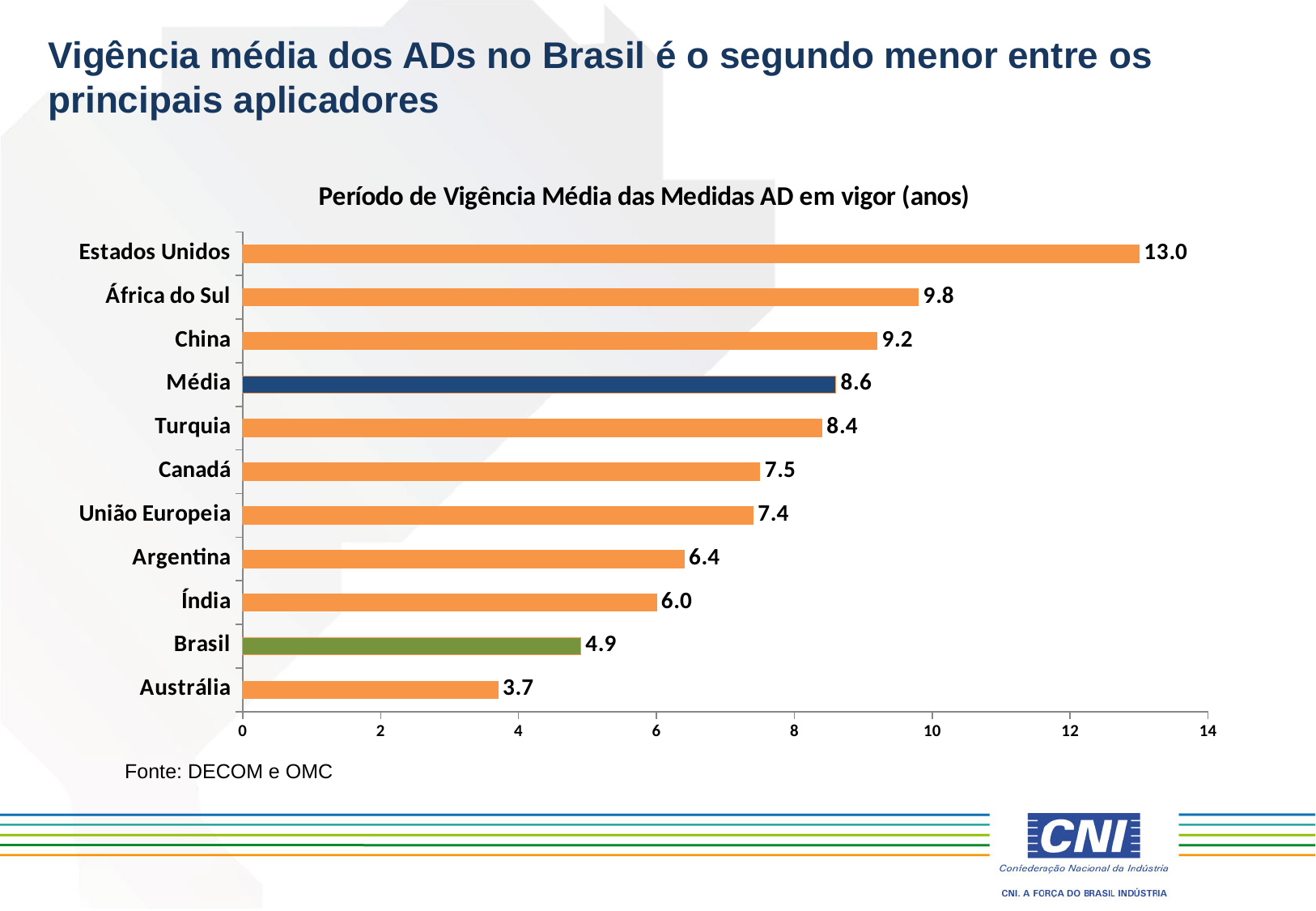
What is the title of the chart? Período de Vigência Média das Medidas AD em vigor (anos) Is the value for Turquia greater or less than 8? greater What kind of chart is shown on the slide? bar chart What is the value for Brasil? 4.9 Which category has the lowest value? Austrália What is the value for Média? 8.6 How many categories are shown in the chart? 11 What is the difference between the values for Média and Brasil? 3.7 Which is larger, the value for China or the value for África do Sul? África do Sul Which category has the highest value? Estados Unidos What is the difference between the values for Estados Unidos and Brasil? 8.1 What is the value for Estados Unidos? 13.0